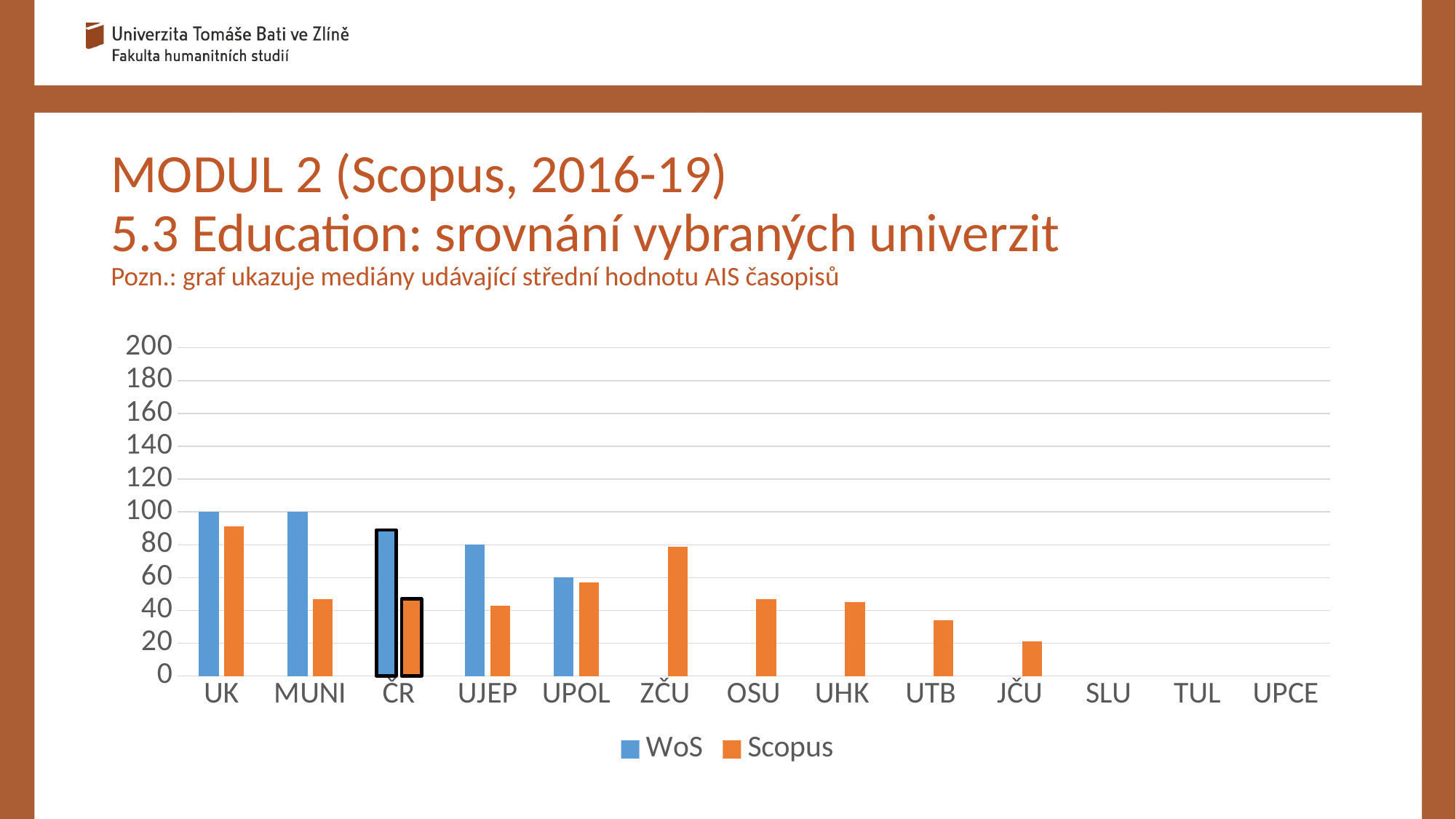
What is the difference between the WoS value for UK and the WoS value for UPOL? 40 What is the WoS value for UK? 100 Which two series are listed in the chart's legend? WoS and Scopus Which category has the highest Scopus value? UK What is the WoS value for UPOL? 60 For MUNI, which is larger, the WoS value or the Scopus value? WoS Is the Scopus value for JČU greater or less than 40? less How many categories are shown on the x axis of the chart? 13 How many series does the chart's legend list? 2 What kind of chart is shown on the slide? bar chart What is the WoS value for UJEP? 80 Is the Scopus value for ZČU greater or less than 60? greater